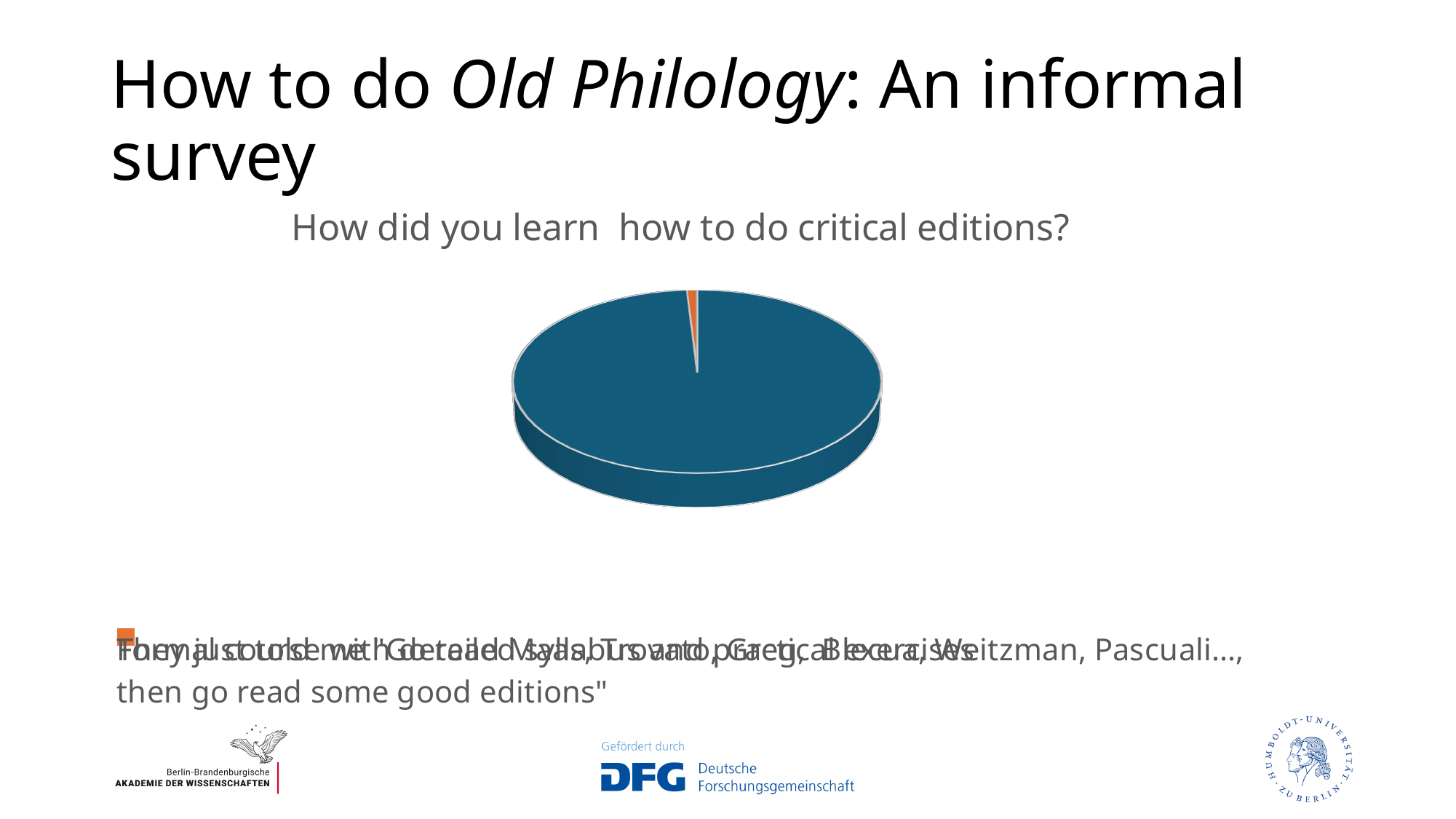
How many slices does the pie chart have? 2 What is the title of the chart? How did you learn how to do critical editions? What kind of chart is shown on the slide? pie chart Which colour is the smallest slice of the pie chart? orange Which slice of the pie chart is larger, the blue one or the orange one? the blue one Which colour is the largest slice of the pie chart? blue